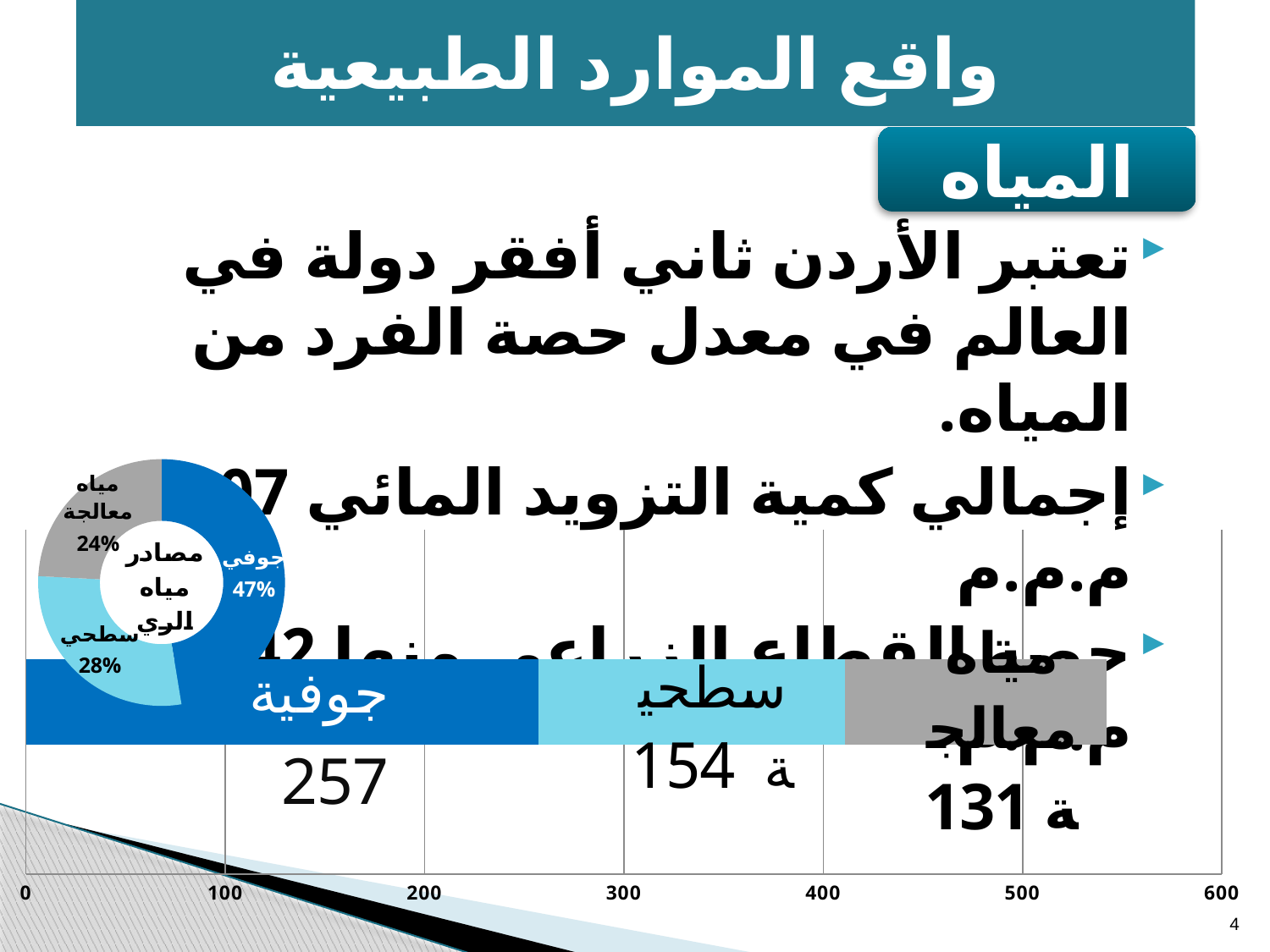
What kind of chart is the chart at the bottom of the slide? Stacked bar chart In the stacked bar chart, what is the value for جوفية? 257 In the doughnut chart, what share is labelled for سطحي? 28% In the stacked bar chart, what is the value for مياه معالجة? 131 In the stacked bar chart, what is the total of the three segments? 542 In the stacked bar chart, what is the difference between the جوفية value and the سطحي value? 103 In the stacked bar chart, what is the value for سطحي? 154 In the doughnut chart, which category has the largest share? جوفي In the doughnut chart, what share is labelled for مياه معالجة? 24% In the doughnut chart, which category has the smallest share? مياه معالجة In the doughnut chart, how many slices are there? 3 In the doughnut chart, what share is labelled for جوفي? 47%